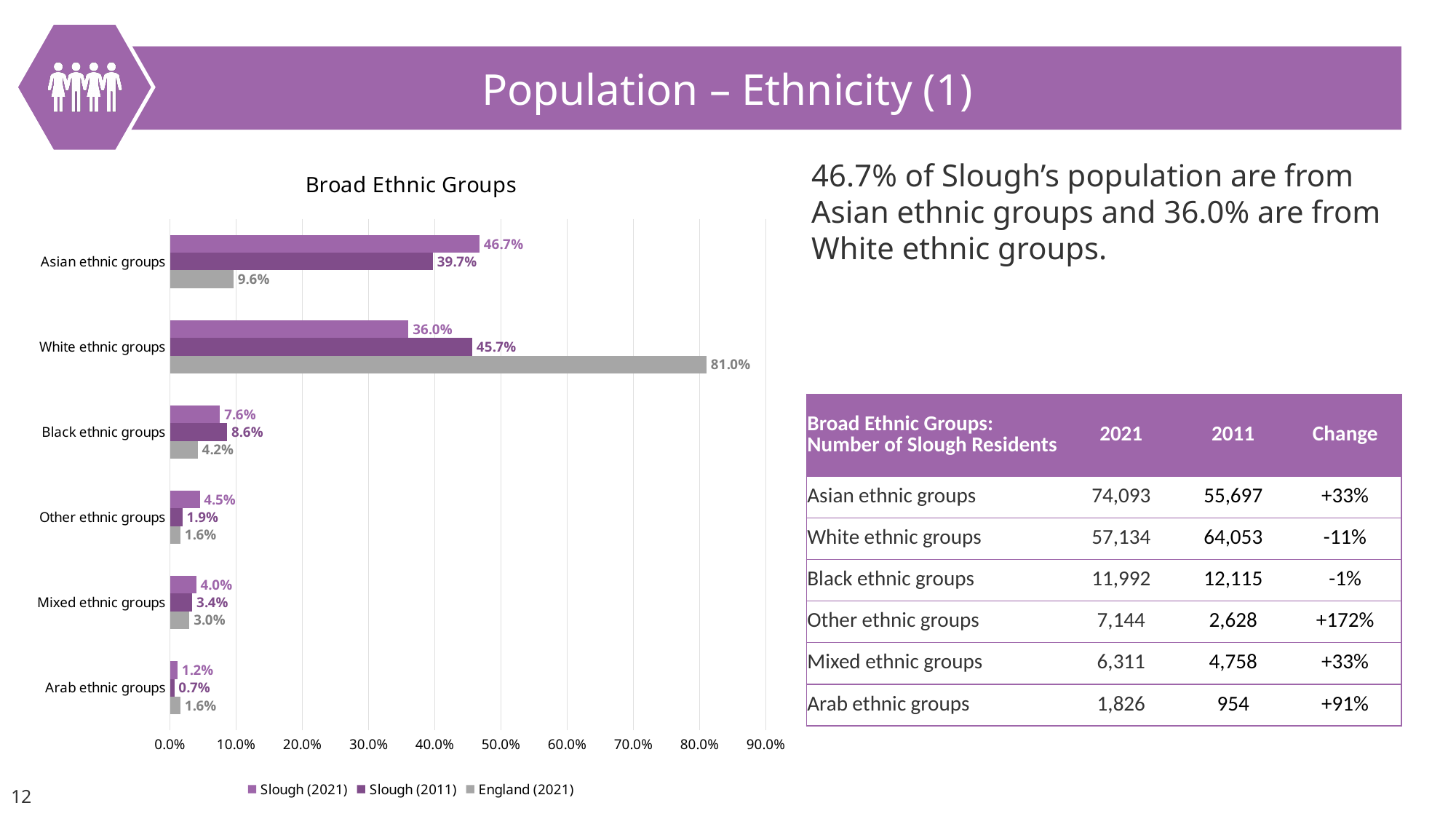
Which is larger for Other ethnic groups: the Slough (2021) value or the England (2021) value? Slough (2021) What is the Slough (2021) value for Asian ethnic groups? 46.7% Which category has the lowest Slough (2011) value? Arab ethnic groups How many series does the chart legend list? 3 Is the Slough (2011) value for Asian ethnic groups greater or less than 30.0%? greater What type of chart is shown on the slide? Bar chart How many ethnic group categories are shown on the chart? 6 What is the difference between the Slough (2021) and Slough (2011) values for White ethnic groups? 9.7% What is the Slough (2011) value for Black ethnic groups? 8.6% What is the title of the chart? Broad Ethnic Groups What is the England (2021) value for White ethnic groups? 81.0% Which category has the highest Slough (2021) value? Asian ethnic groups